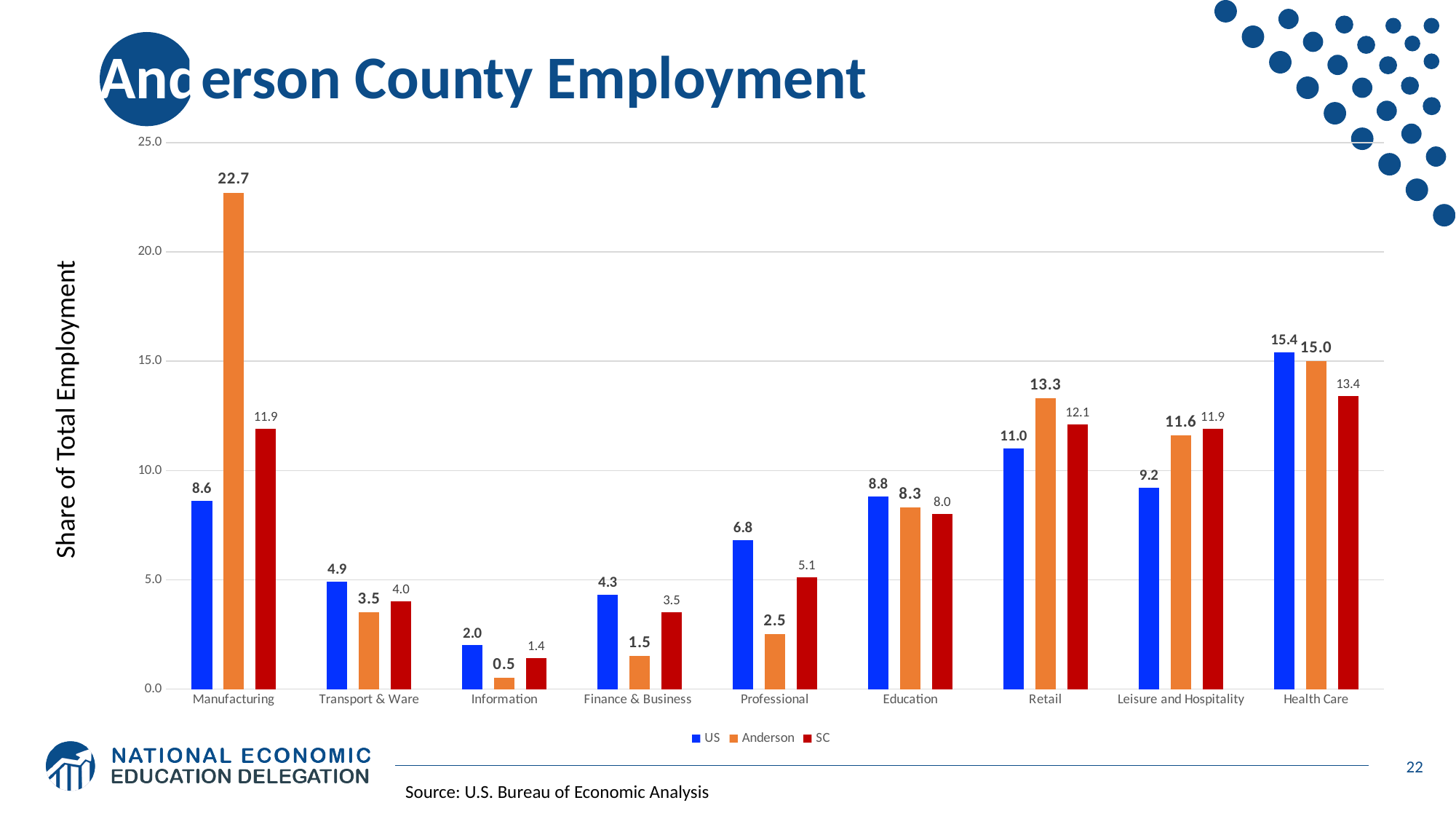
What is the label on the vertical axis? Share of Total Employment Which category has the highest Anderson value? Manufacturing How many categories are shown on the x axis? 9 What is the US value for Leisure and Hospitality? 9.2 What kind of chart is shown on the slide? bar chart Which category has the lowest US value? Information What is the SC value for Professional? 5.1 How many series does the legend list? 3 Is the SC value for Health Care greater or less than 15.0? less What is the difference between the Anderson and SC values for Manufacturing? 10.8 Which is larger for Retail, the US value or the Anderson value? Anderson What is the Anderson value for Manufacturing? 22.7